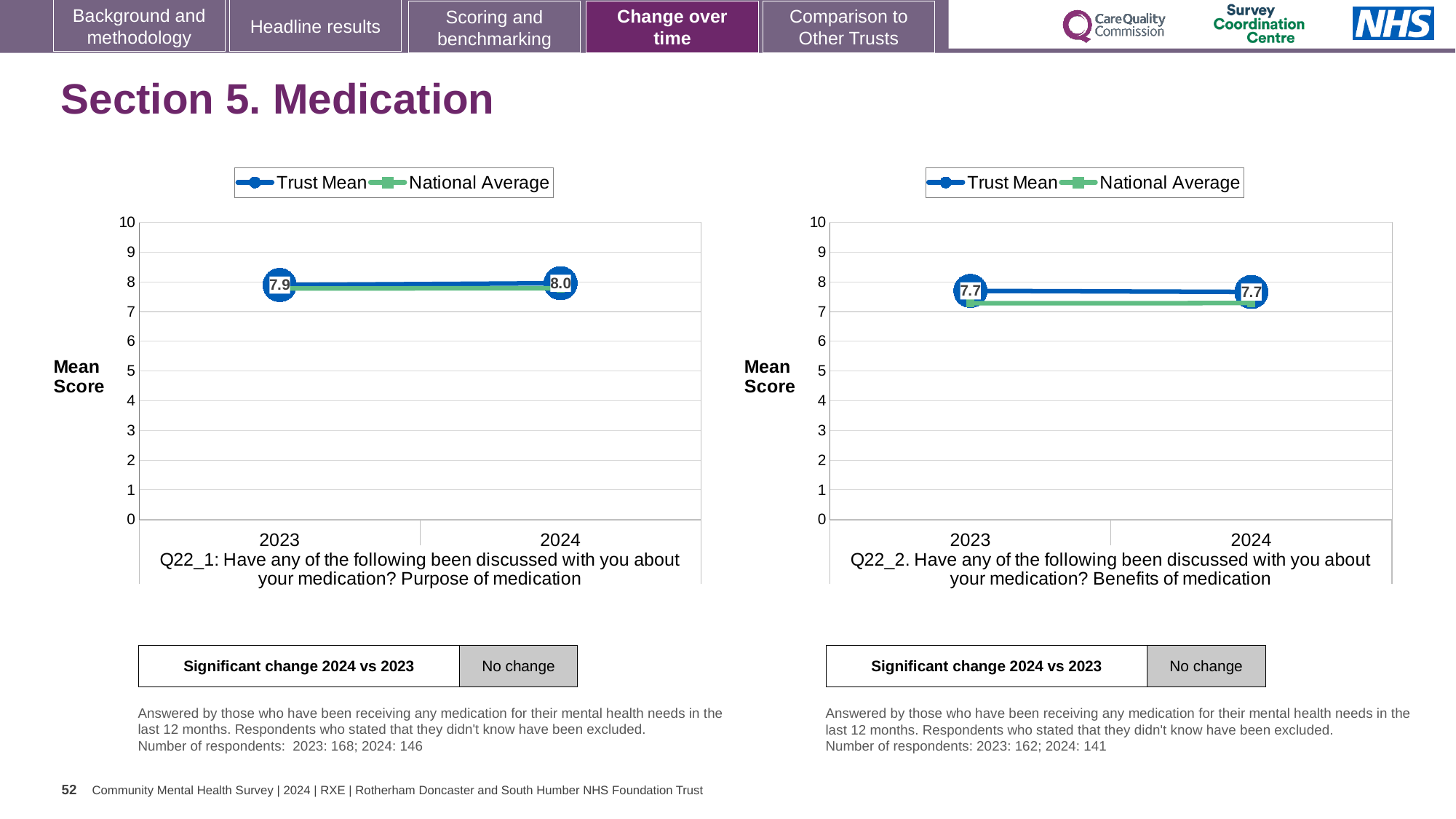
How many years are plotted on the x axis of the left chart (Q22_1)? 2 In the right chart (Q22_2), is the National Average for 2024 greater or less than 8? less What type of chart is used on the left of the slide (Q22_1)? line chart In the left chart (Q22_1: Purpose of medication), what is the Trust Mean for 2024? 8.0 In the right chart (Q22_2), which is larger for 2024: the Trust Mean or the National Average? Trust Mean In the right chart (Q22_2), did the Trust Mean rise, fall or stay the same from 2023 to 2024? stay the same In the left chart (Q22_1), by how much did the Trust Mean change from 2023 to 2024? 0.1 In the right chart (Q22_2: Benefits of medication), what is the Trust Mean for 2024? 7.7 How many series does the legend of the right chart (Q22_2) list? 2 In the left chart (Q22_1: Purpose of medication), what is the Trust Mean for 2023? 7.9 What does the box below the right chart (Q22_2) say about significant change 2024 vs 2023? No change In the left chart (Q22_1), did the Trust Mean rise or fall from 2023 to 2024? rise